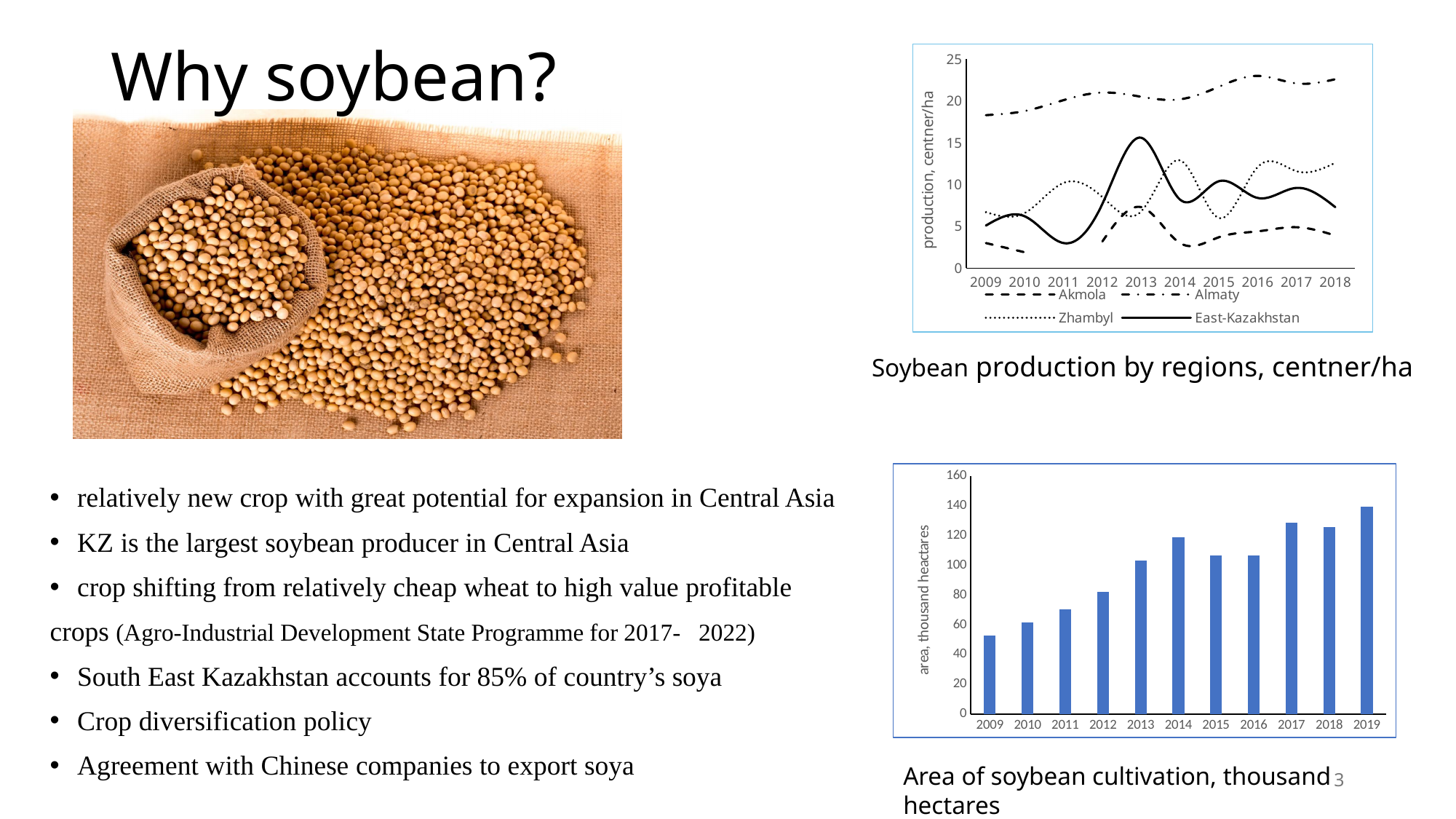
What kind of chart is the 'Area of soybean cultivation, thousand hectares' chart? bar chart In the 'Soybean production by regions' chart, which region has the highest production in 2018? Almaty In the 'Soybean production by regions' chart, what is the label of the y axis? production, centner/ha In the 'Area of soybean cultivation' chart, is the value for 2009 greater or less than 60? less In the 'Area of soybean cultivation' chart, is the value for 2019 greater or less than 120? greater In the 'Area of soybean cultivation' chart, which is larger, the value for 2013 or the value for 2014? 2014 In the 'Area of soybean cultivation' chart, which year has the highest value? 2019 In the 'Soybean production by regions' chart, how many series does the legend list? 4 What kind of chart is the 'Soybean production by regions, centner/ha' chart? line chart In the 'Area of soybean cultivation' chart, how many years are shown on the x axis? 11 In the 'Area of soybean cultivation' chart, which year has the lowest value? 2009 In the 'Soybean production by regions' chart, is the value for Almaty in 2018 greater or less than 20? greater